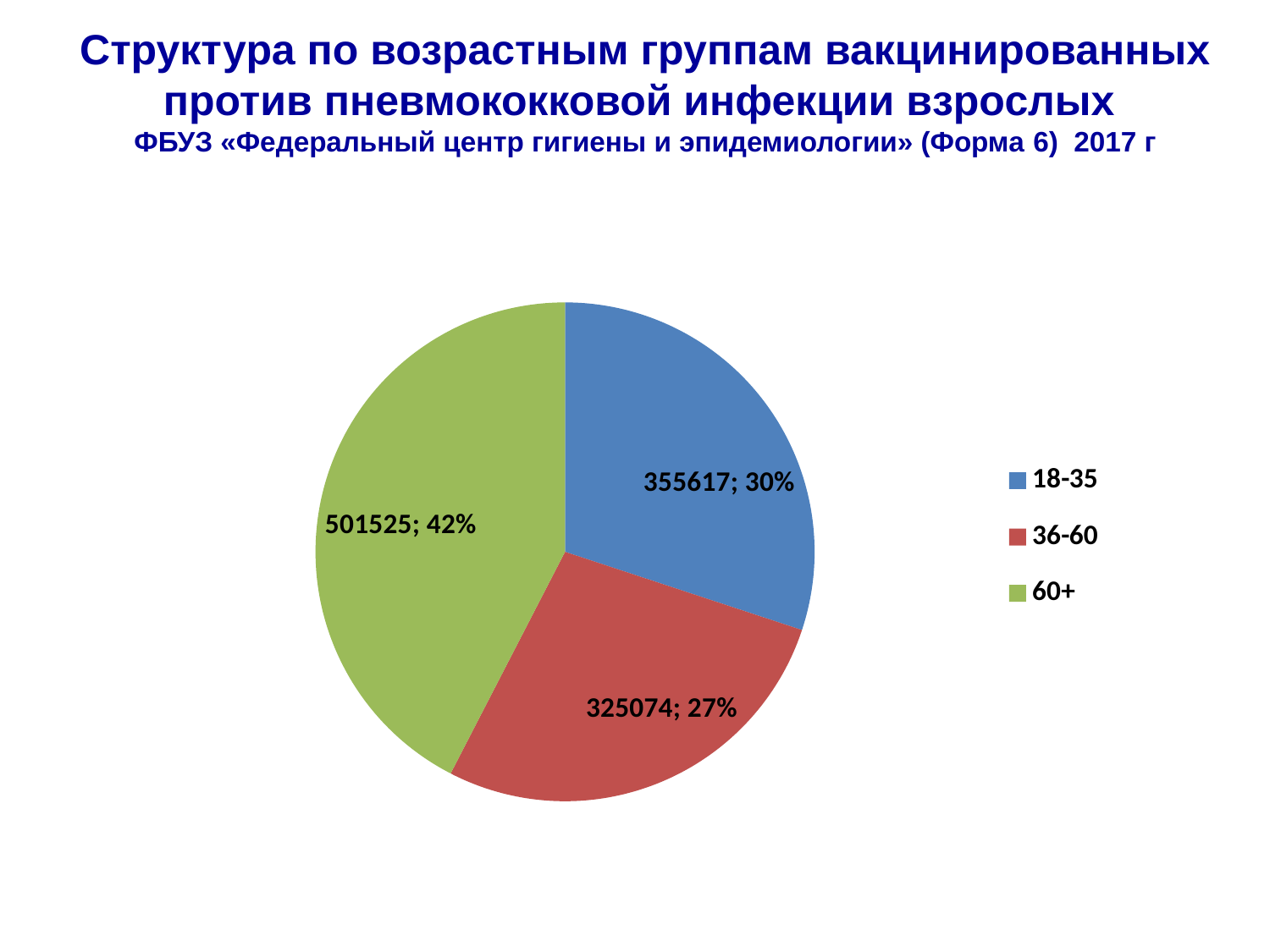
What is the value for the 18-35 age group? 355617 What is the difference between the values for 60+ and 18-35? 145908 What is the value for the 36-60 age group? 325074 Which age group has the smallest slice? 36-60 Which colour represents the 36-60 age group in the legend? red Which age group has the largest slice? 60+ What kind of chart is shown on the slide? pie chart How many slices does the pie chart have? 3 How many entries does the legend list? 3 What share of the pie does the 60+ age group represent? 42% What is the value for the 60+ age group? 501525 What share of the pie does the 36-60 age group represent? 27%